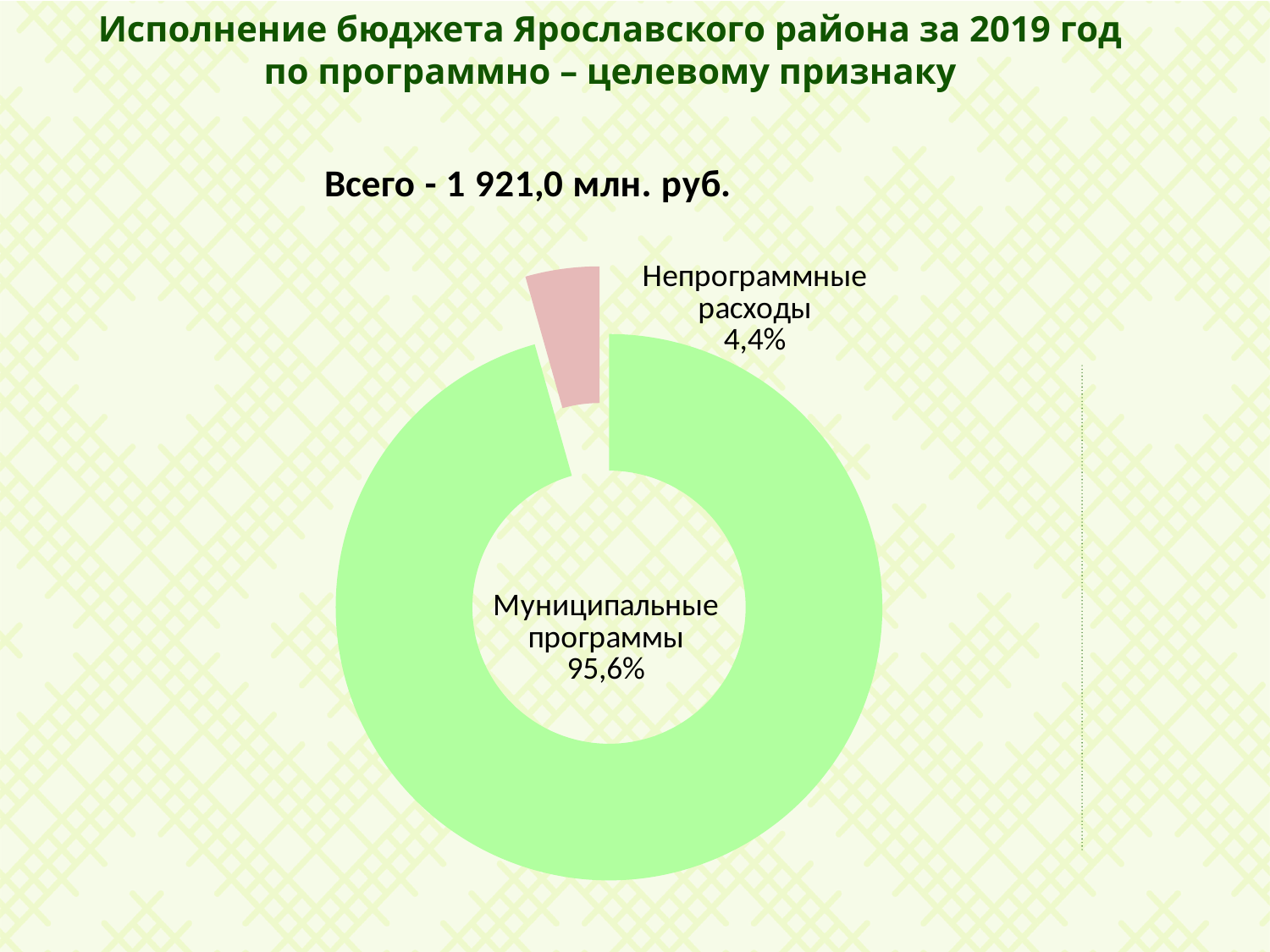
What total amount is stated above the chart? 1 921,0 млн. руб. What share of the budget execution is shown for Муниципальные программы? 95,6% Which category has the largest share in the chart? Муниципальные программы Which category has the smallest share in the chart? Непрограммные расходы What colour is the slice for Непрограммные расходы? Pink What is the difference in percentage points between the shares of Муниципальные программы and Непрограммные расходы? 91,2 What kind of chart is shown on the slide? Doughnut (pie) chart How many categories are shown in the chart? 2 Which is larger: the share of Муниципальные программы or the share of Непрограммные расходы? Муниципальные программы What share of the budget execution is shown for Непрограммные расходы? 4,4%